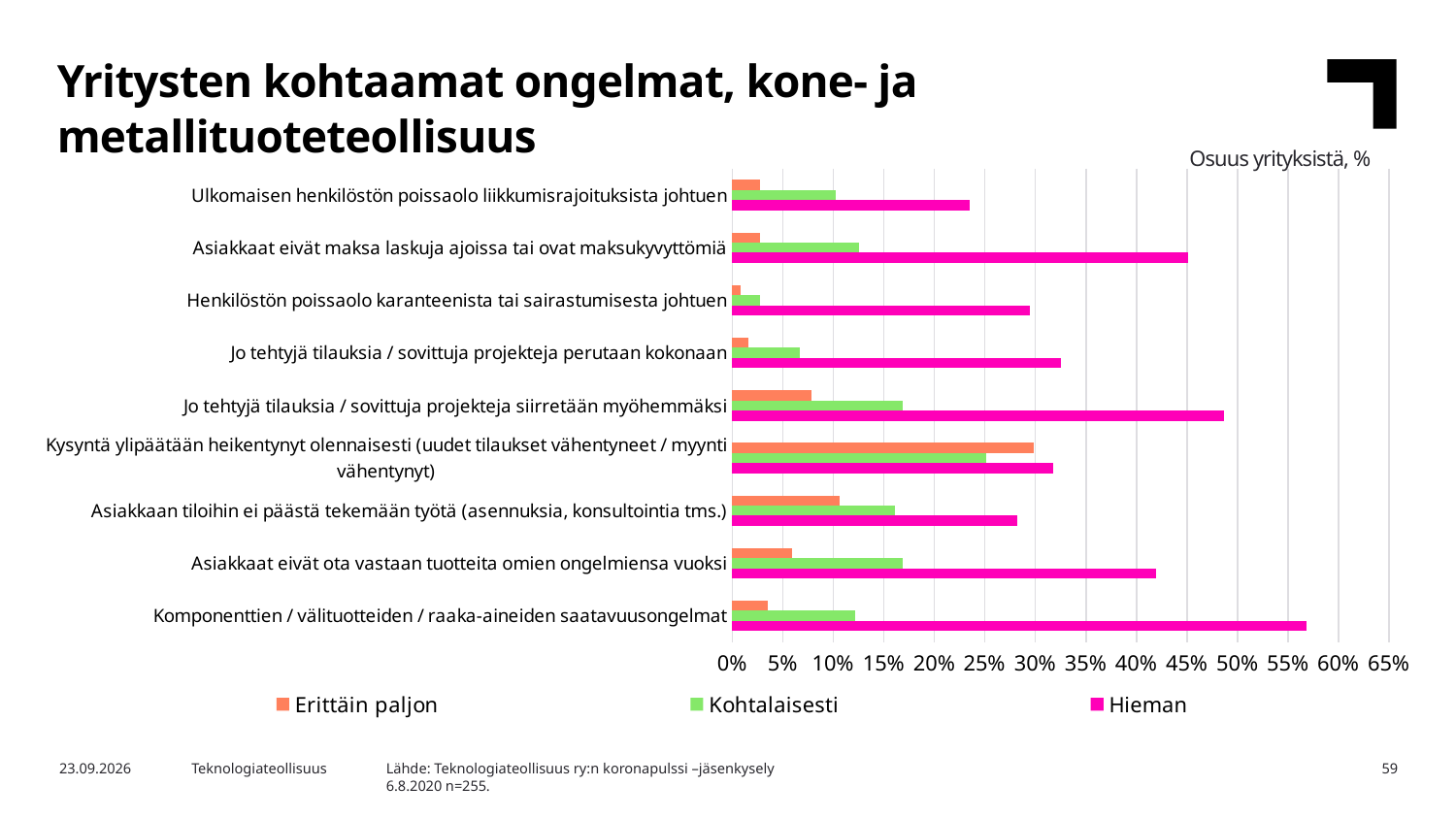
Is the 'Hieman' value for 'Komponenttien / välituotteiden / raaka-aineiden saatavuusongelmat' greater or less than 55%? greater Is the 'Kohtalaisesti' value for 'Ulkomaisen henkilöstön poissaolo liikkumisrajoituksista johtuen' greater or less than 15%? less How many series does the legend list? 3 Which is larger: the 'Hieman' value for 'Asiakkaat eivät ota vastaan tuotteita omien ongelmiensa vuoksi' or the 'Hieman' value for 'Asiakkaan tiloihin ei päästä tekemään työtä'? Asiakkaat eivät ota vastaan tuotteita omien ongelmiensa vuoksi What unit label is shown above the chart's axis? Osuus yrityksistä, % How many problem categories are plotted on the chart? 9 Which category has the longest 'Hieman' bar? Komponenttien / välituotteiden / raaka-aineiden saatavuusongelmat Which category has the shortest 'Erittäin paljon' bar? Henkilöstön poissaolo karanteenista tai sairastumisesta johtuen Is the 'Erittäin paljon' value for 'Kysyntä ylipäätään heikentynyt olennaisesti' greater or less than 25%? greater Which category has the longest 'Erittäin paljon' bar? Kysyntä ylipäätään heikentynyt olennaisesti (uudet tilaukset vähentyneet / myynti vähentynyt) What kind of chart is shown on the slide? Bar chart